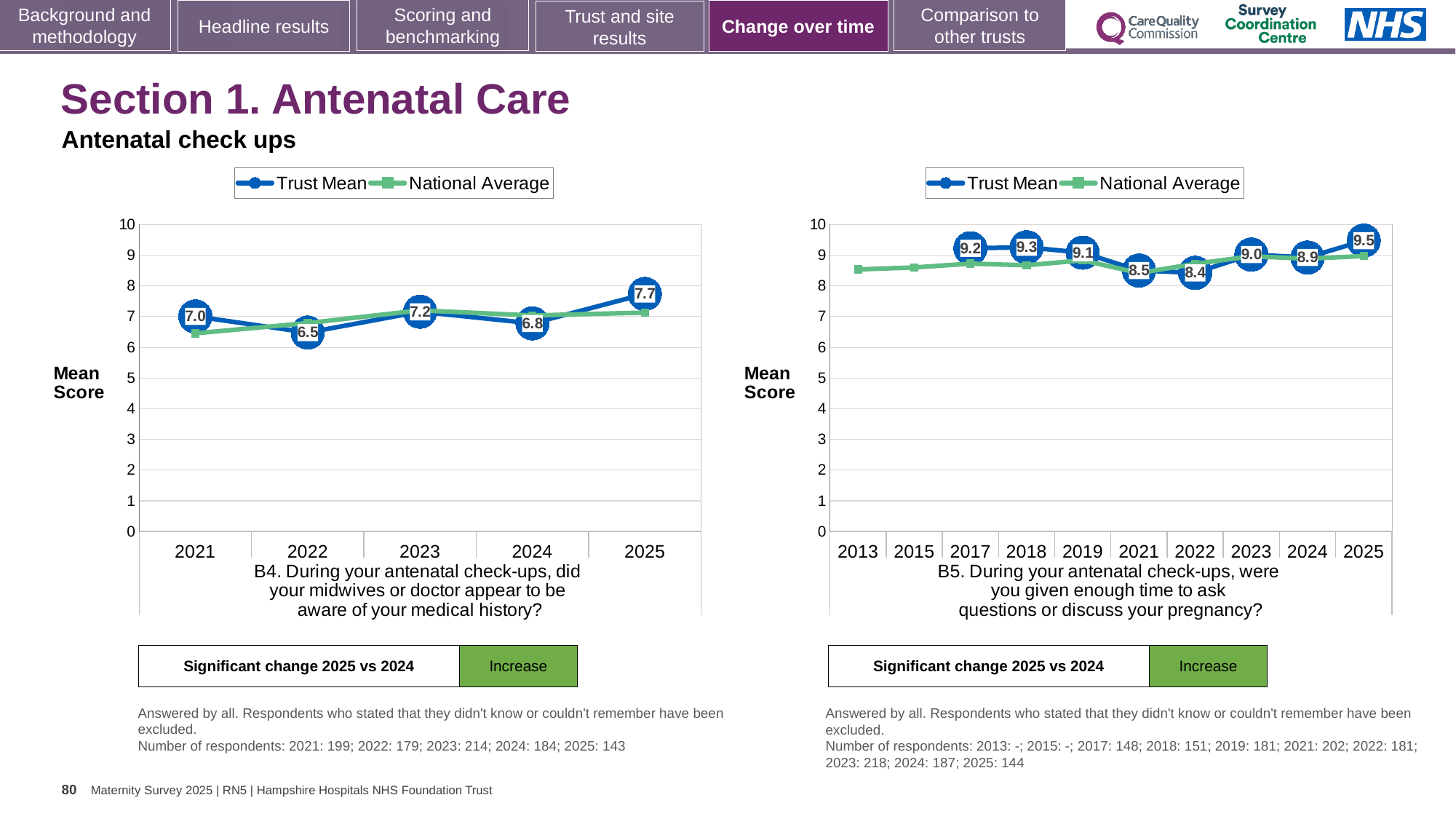
In the right chart (B5), which year has the highest Trust Mean? 2025 In the right chart (B5), what is the Trust Mean for 2018? 9.3 In the left chart (B4), which year has the lowest Trust Mean? 2022 What type of chart is used on the left (B4)? Line chart In the right chart (B5), what is the difference between the Trust Mean for 2025 and 2022? 1.1 In the left chart (B4), what is the difference between the Trust Mean for 2025 and 2024? 0.9 In the right chart (B5), what is the Trust Mean for 2022? 8.4 In the right chart (B5), how many series does the legend list? 2 In the left chart (B4), what is the Trust Mean for 2022? 6.5 In the right chart (B5), is the Trust Mean for 2025 higher or lower than for 2024? higher In the left chart (B4), how many years are shown on the x axis? 5 In the left chart (B4), what is the Trust Mean for 2025? 7.7